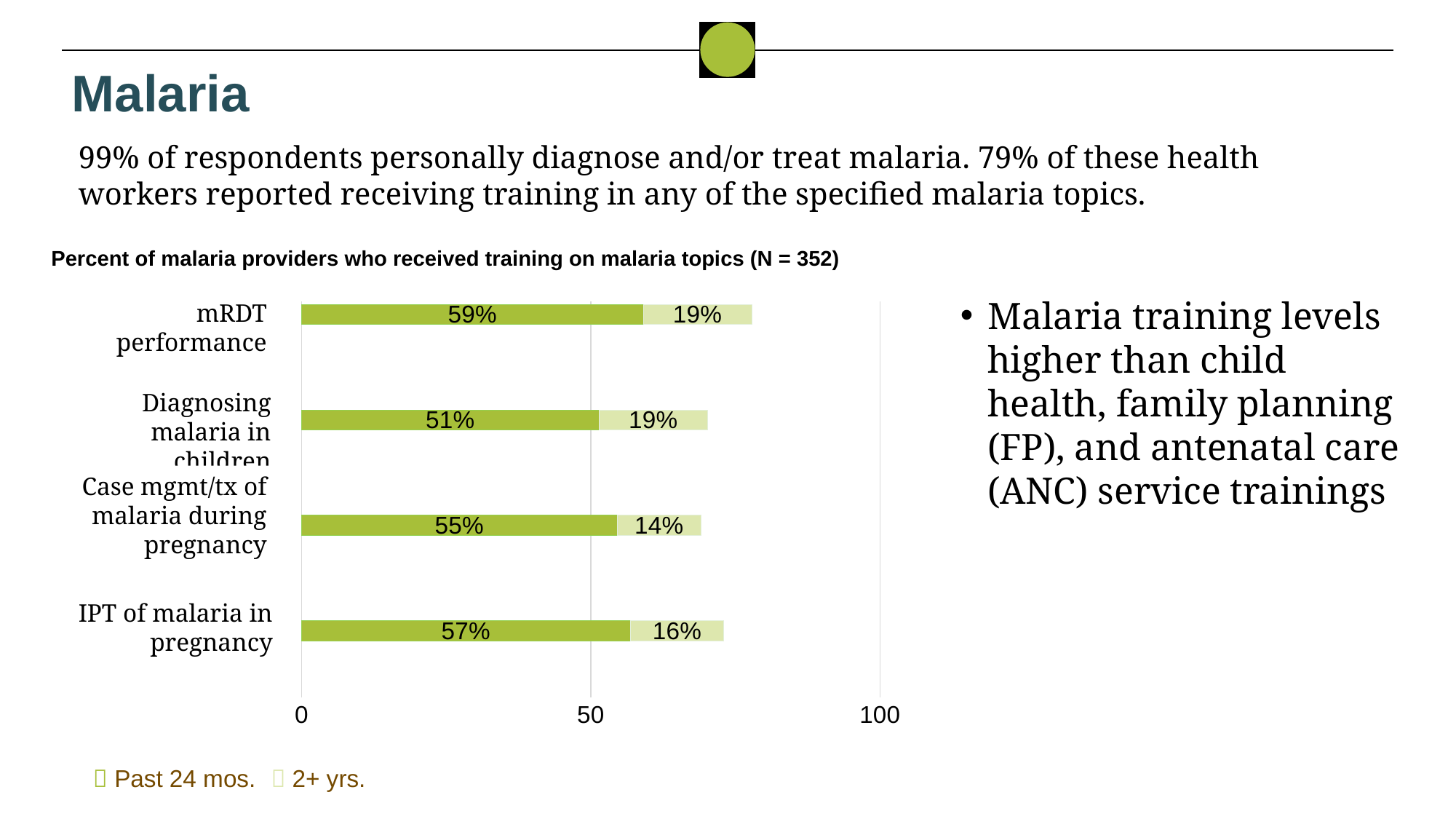
How many malaria topics are shown in the chart? 4 What is the difference between the 'Past 24 mos.' values for mRDT performance and diagnosing malaria in children? 8% What is the total of the stacked bar for mRDT performance? 78% How many series does the legend list? 2 Which malaria topic has the highest 'Past 24 mos.' training percentage? mRDT performance What percent of malaria providers received training on IPT of malaria in pregnancy 2+ years ago? 16% What type of chart is shown on the slide? Stacked bar chart What percent of malaria providers received training on mRDT performance in the past 24 months? 59% Which malaria topic has the lowest '2+ yrs.' training percentage? Case mgmt/tx of malaria during pregnancy What is the total of the stacked bar for IPT of malaria in pregnancy? 73% Which is larger: the 'Past 24 mos.' value for IPT of malaria in pregnancy or for case mgmt/tx of malaria during pregnancy? IPT of malaria in pregnancy What is the 'Past 24 mos.' value for case mgmt/tx of malaria during pregnancy? 55%